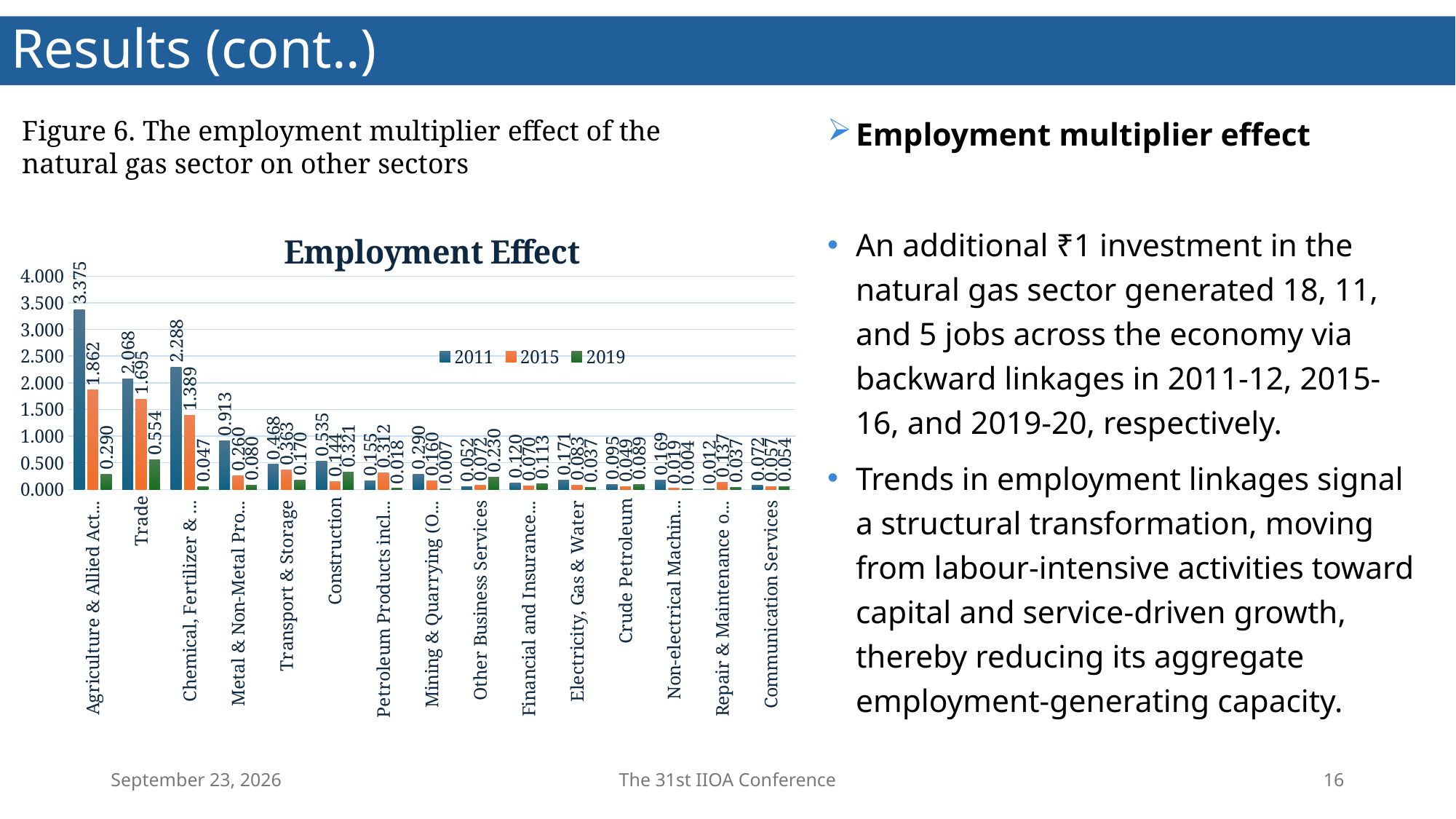
How many sectors are shown on the x axis of the Employment Effect chart? 15 What kind of chart is the Employment Effect chart? Bar chart What is the 2019 employment effect value for Construction? 0.321 What is the 2011 employment effect value for Trade? 2.068 Which sector has the highest 2019 employment effect? Trade What is the 2015 value for Communication Services? 0.057 What is the difference between the 2011 and 2019 values for Agriculture & Allied Act...? 3.085 Is the 2011 value for Chemical, Fertilizer & ... greater or less than 2.000? greater How many series does the legend of the Employment Effect chart list? 3 Which is larger in 2015: Trade or Chemical, Fertilizer & ...? Trade Which sector has the highest 2011 employment effect? Agriculture & Allied Act... Do the values for Agriculture & Allied Act... rise or fall from 2011 to 2019? Fall